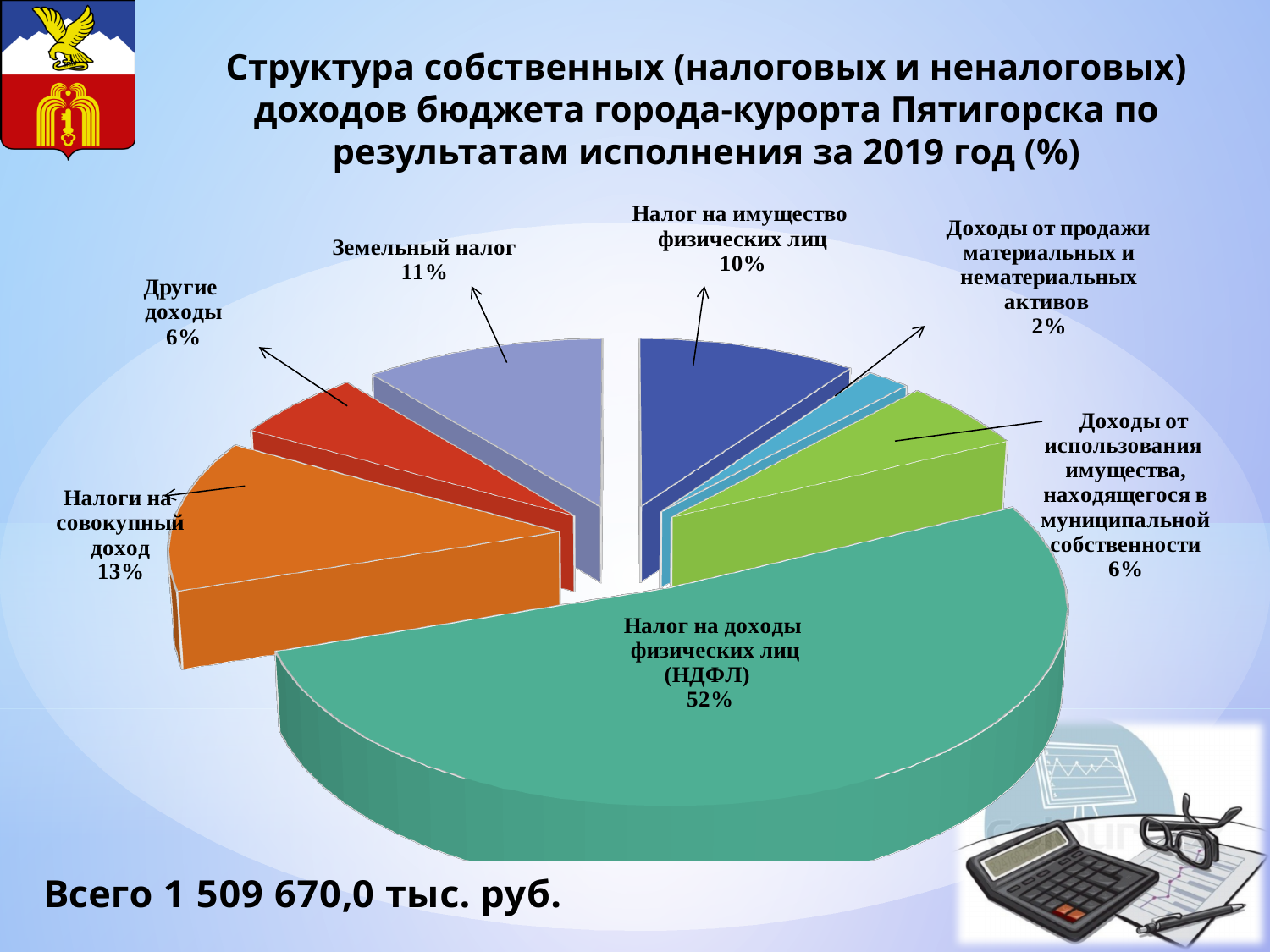
What is the value shown for "Земельный налог"? 11% What is the value shown for "Доходы от продажи материальных и нематериальных активов"? 2% What is the value shown for "Налог на имущество физических лиц"? 10% Which category has the largest share of the pie? Налог на доходы физических лиц (НДФЛ) What share of the pie does "Налог на доходы физических лиц (НДФЛ)" have? 52% What is the difference in percentage points between "Налоги на совокупный доход" and "Земельный налог"? 2 Which category has the smallest share of the pie? Доходы от продажи материальных и нематериальных активов What kind of chart is shown on the slide? Pie chart How many slices does the pie chart have? 7 Which is larger: "Земельный налог" or "Налог на имущество физических лиц"? Земельный налог What total amount is stated below the chart? 1 509 670,0 тыс. руб. What is the value shown for "Налоги на совокупный доход"? 13%